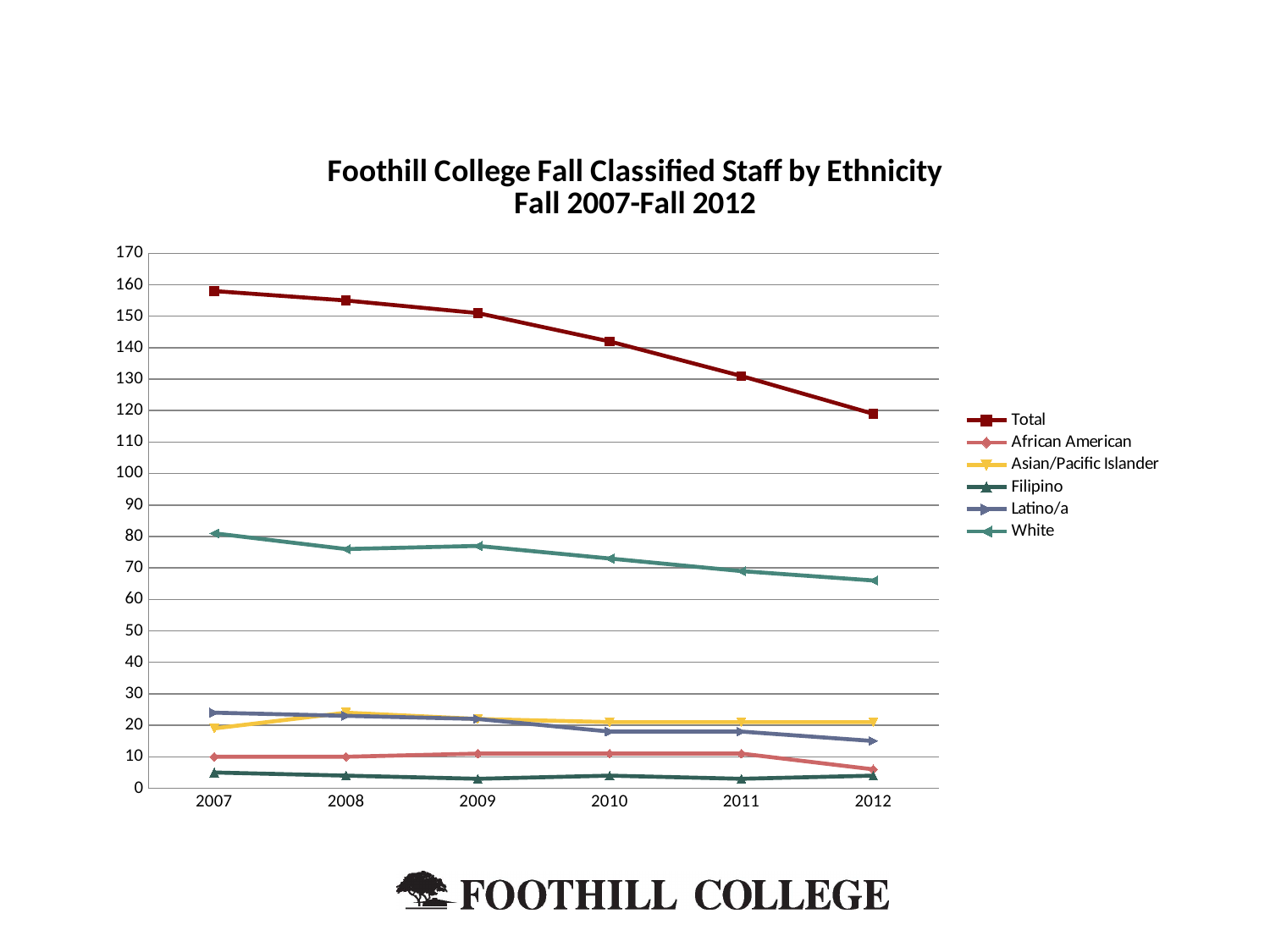
In 2010, which is larger: the value for White or the value for Latino/a? White Is the value for White in 2012 greater or less than 70? less What kind of chart is shown on the slide? line chart In 2012, which is larger: the value for Asian/Pacific Islander or the value for Latino/a? Asian/Pacific Islander Is the value for Latino/a in 2012 greater or less than 20? less How many series does the legend list? 6 How many years are plotted along the x axis? 6 Is the value for Total in 2007 greater or less than 150? greater What is the title of the chart? Foothill College Fall Classified Staff by Ethnicity Fall 2007-Fall 2012 Does the Total series rise or fall from 2007 to 2012? fall Which series has the lowest value in 2007? Filipino